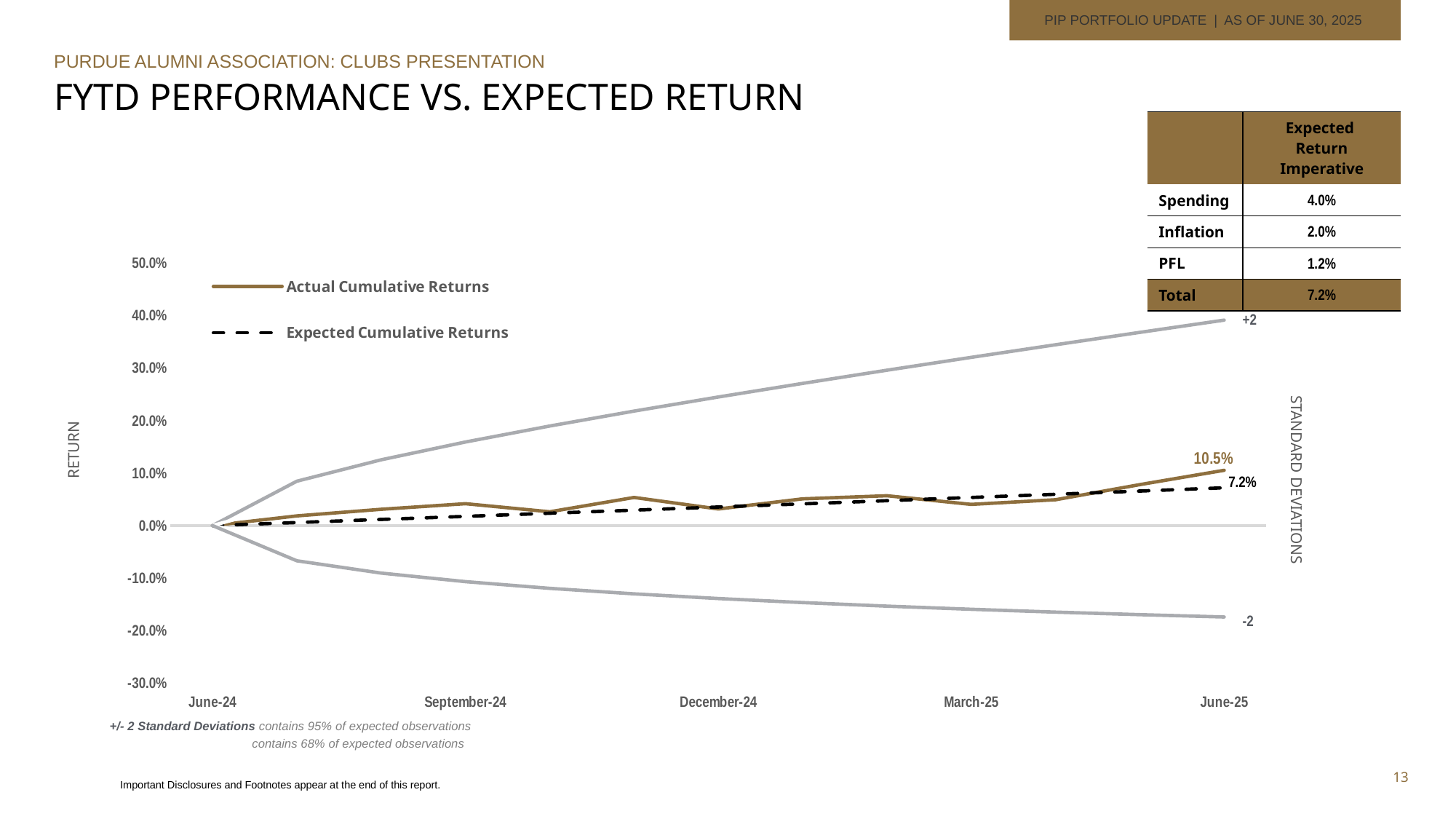
How many series does the chart legend list? 2 Is the value of Expected Cumulative Returns at June-25 greater or less than 10.0%? less At June-25, which is larger: Actual Cumulative Returns or Expected Cumulative Returns? Actual Cumulative Returns What is the value of Actual Cumulative Returns at June-25? 10.5% Does the Expected Cumulative Returns line rise or fall from June-24 to June-25? Rise What is the difference between Actual Cumulative Returns and Expected Cumulative Returns at June-25? 3.3% Is the +2 standard deviation line at June-25 greater or less than 30.0%? greater Is the value of Actual Cumulative Returns at June-25 greater or less than 10.0%? greater What kind of chart is shown on the slide? Line chart What is the label of the chart's vertical axis? RETURN What is the value of Expected Cumulative Returns at June-25? 7.2%